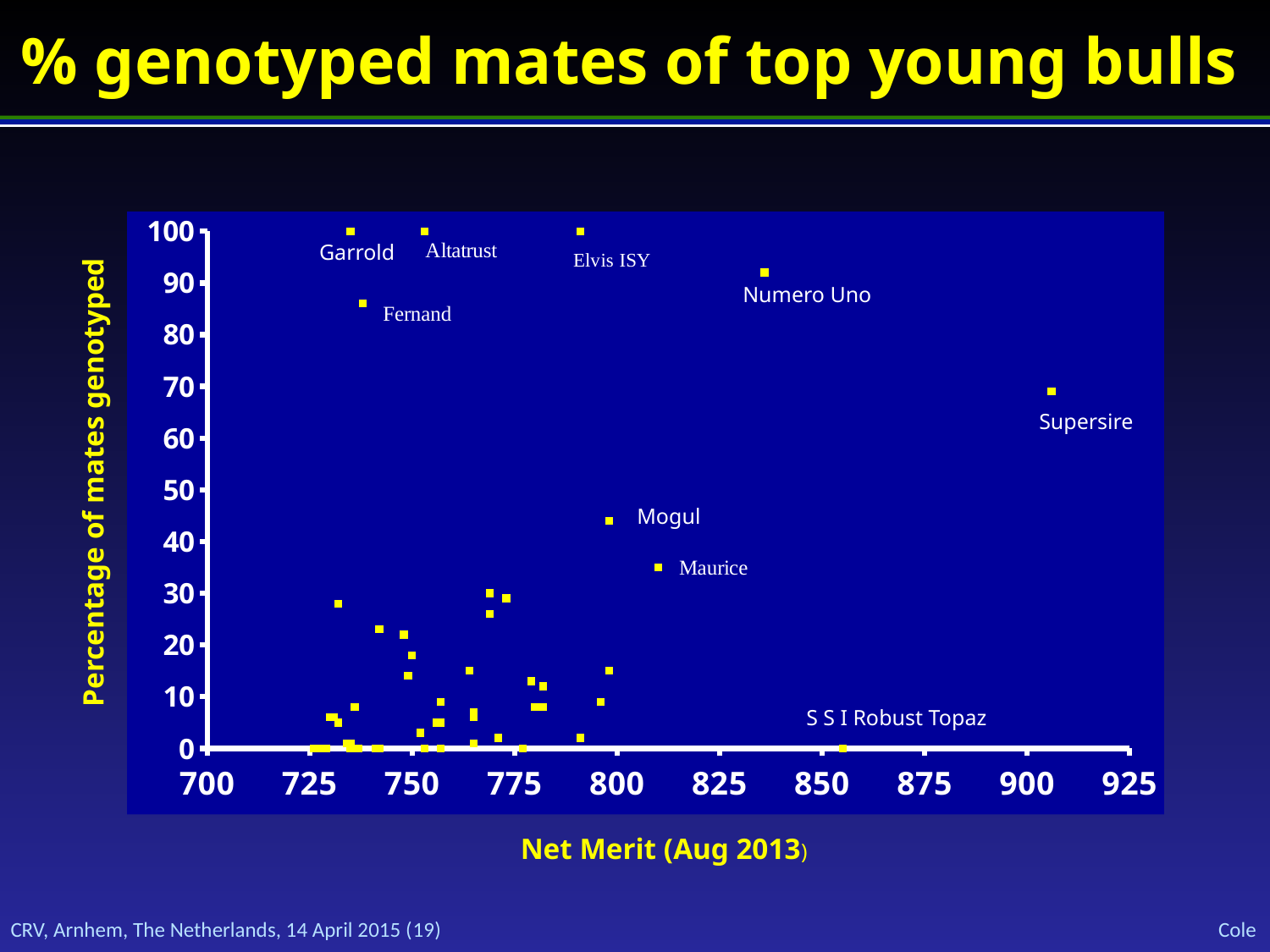
Is the percentage of mates genotyped for Numero Uno greater or less than 80? greater Is the Net Merit value for Supersire greater or less than 900? greater What is the percentage of mates genotyped for Garrold? 100 What is the percentage of mates genotyped for S S I Robust Topaz? 0 Which has a higher percentage of mates genotyped, Supersire or Numero Uno? Numero Uno What is the label of the x axis? Net Merit (Aug 2013) Is the percentage of mates genotyped for Fernand greater or less than 80? greater Which has a higher percentage of mates genotyped, Mogul or Maurice? Mogul What kind of chart is shown on the slide? scatter plot